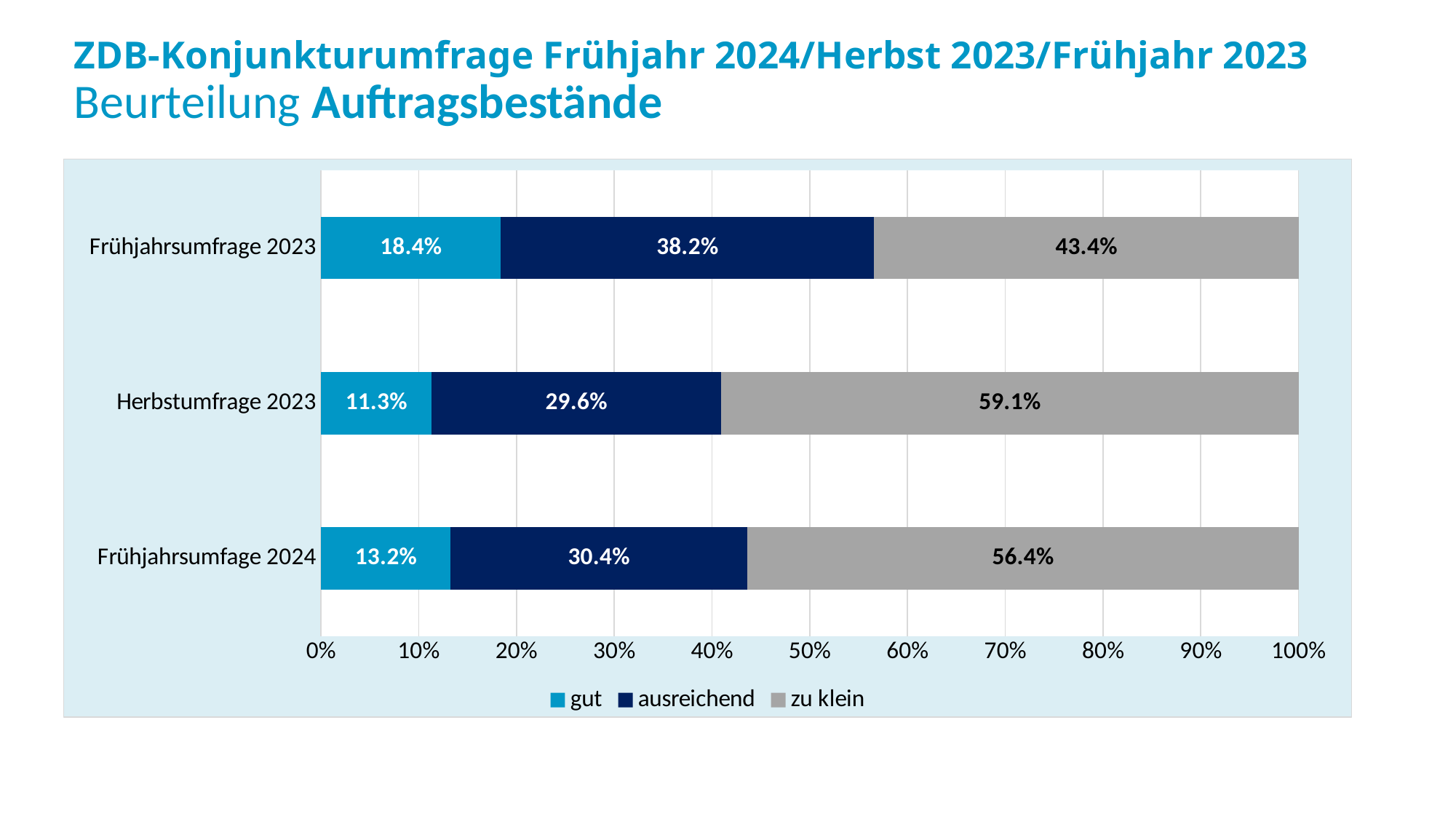
What is the value for "ausreichend" in Frühjahrsumfage 2024? 30.4% How many surveys (bars) are shown in the chart? 3 How many series does the legend list? 3 What is the value for "zu klein" in Herbstumfrage 2023? 59.1% Which survey has the lowest value for "gut"? Herbstumfrage 2023 What is the difference between the "zu klein" values for Herbstumfrage 2023 and Frühjahrsumfrage 2023? 15.7% What kind of chart is shown on the slide? Stacked bar chart Which colour represents "zu klein" in the legend? Grey What is the value for "gut" in Frühjahrsumfrage 2023? 18.4% Which survey has the highest value for "zu klein"? Herbstumfrage 2023 What is the total of the stacked bar for Frühjahrsumfage 2024? 100% Which is larger: the "ausreichend" value for Frühjahrsumfrage 2023 or for Frühjahrsumfage 2024? Frühjahrsumfrage 2023